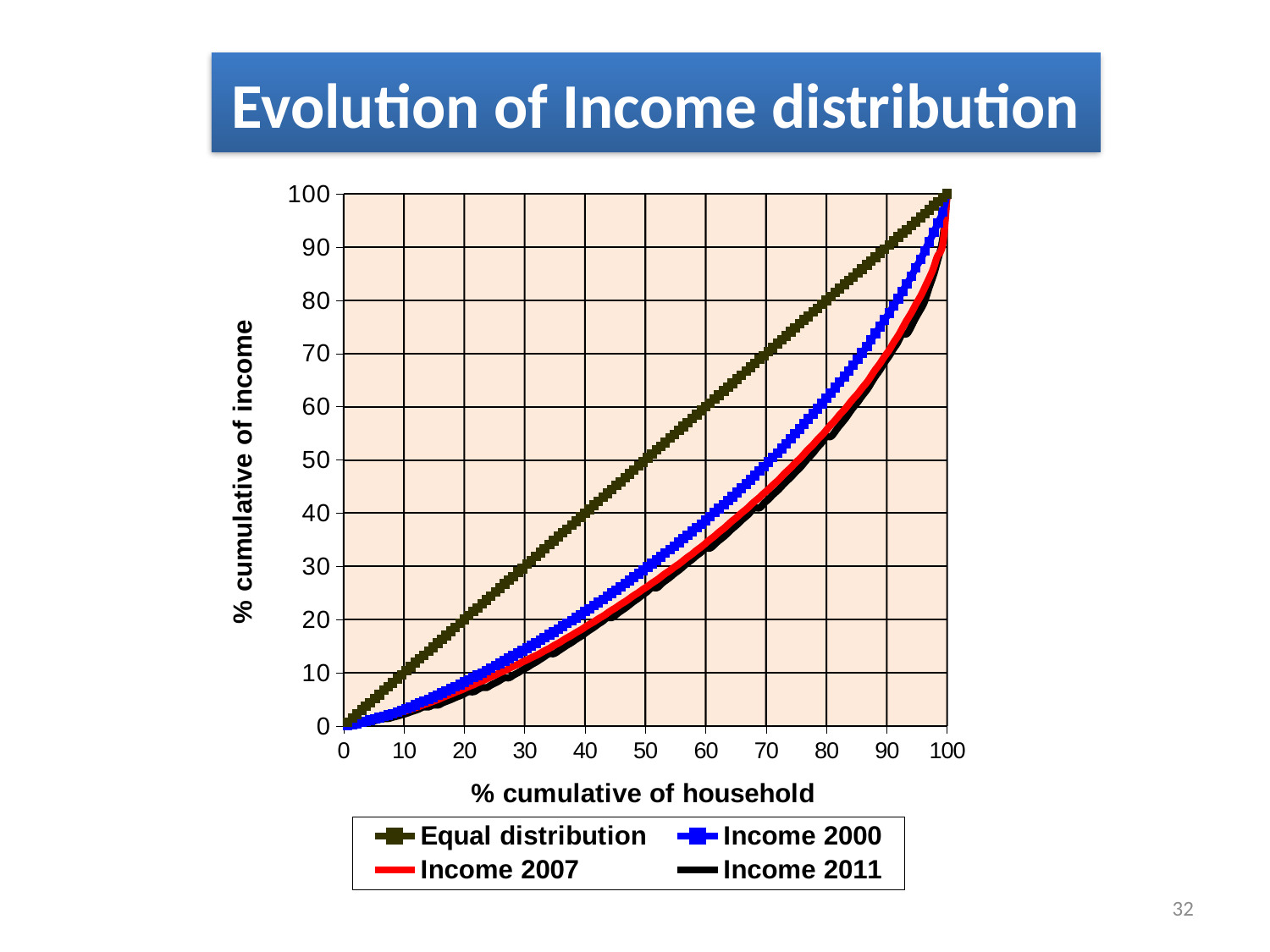
Is the value of Income 2000 at 50% cumulative of household greater or less than 40? less What kind of chart is shown on the slide? line chart Is the value of Income 2011 at 80% cumulative of household greater or less than 60? less What is the title of the slide's chart? Evolution of Income distribution How many series does the legend list? 4 Is the value of Income 2000 at 80% cumulative of household greater or less than 50? greater At 60% cumulative of household, which is higher: Income 2000 or Income 2011? Income 2000 Do the values of the Income 2011 series rise or fall as % cumulative of household increases? rise Among the three Income series, which one lies highest on the chart? Income 2000 What is the value of the Equal distribution series at 100% cumulative of household? 100 What is the value of the Equal distribution series at 50% cumulative of household? 50 What is the label of the y axis? % cumulative of income